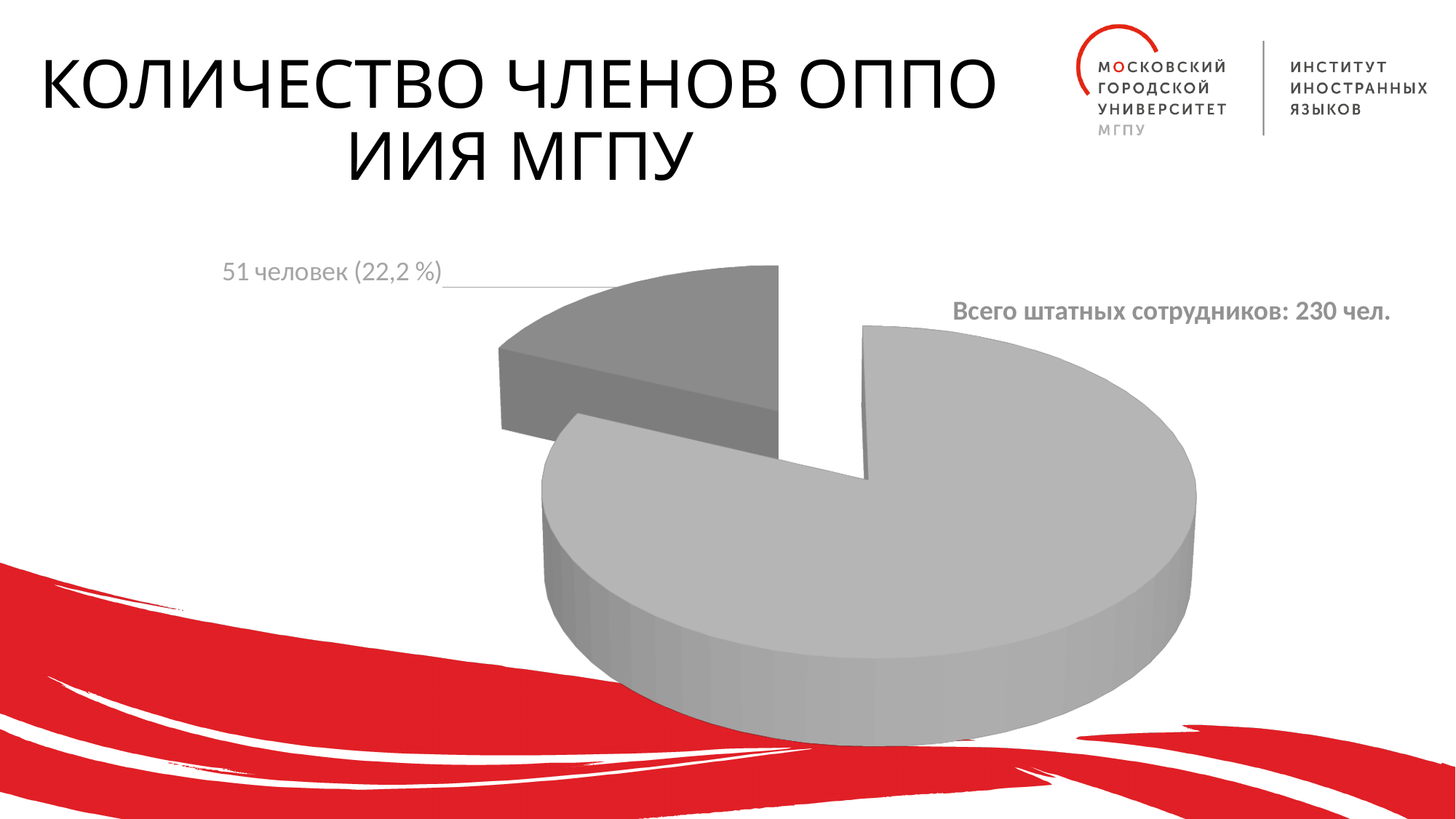
How many people does the labelled (separated) slice of the pie chart represent? 51 человек Which slice is larger: the one labelled "51 человек (22,2 %)" or the unlabelled slice? The unlabelled slice How many slices does the pie chart have? 2 What share of the pie does the slice labelled "51 человек" represent? 22,2 % According to the text next to the chart, what is the total number of staff employees? 230 чел. What kind of chart is shown on the slide? Pie chart How many more people are in the total staff (230) than in the slice labelled "51 человек"? 179 Which slice of the pie chart is the smallest? 51 человек (22,2 %) Is the share of the slice labelled "51 человек" greater or less than 50%? less What is the title of the slide containing the pie chart? КОЛИЧЕСТВО ЧЛЕНОВ ОППО ИИЯ МГПУ